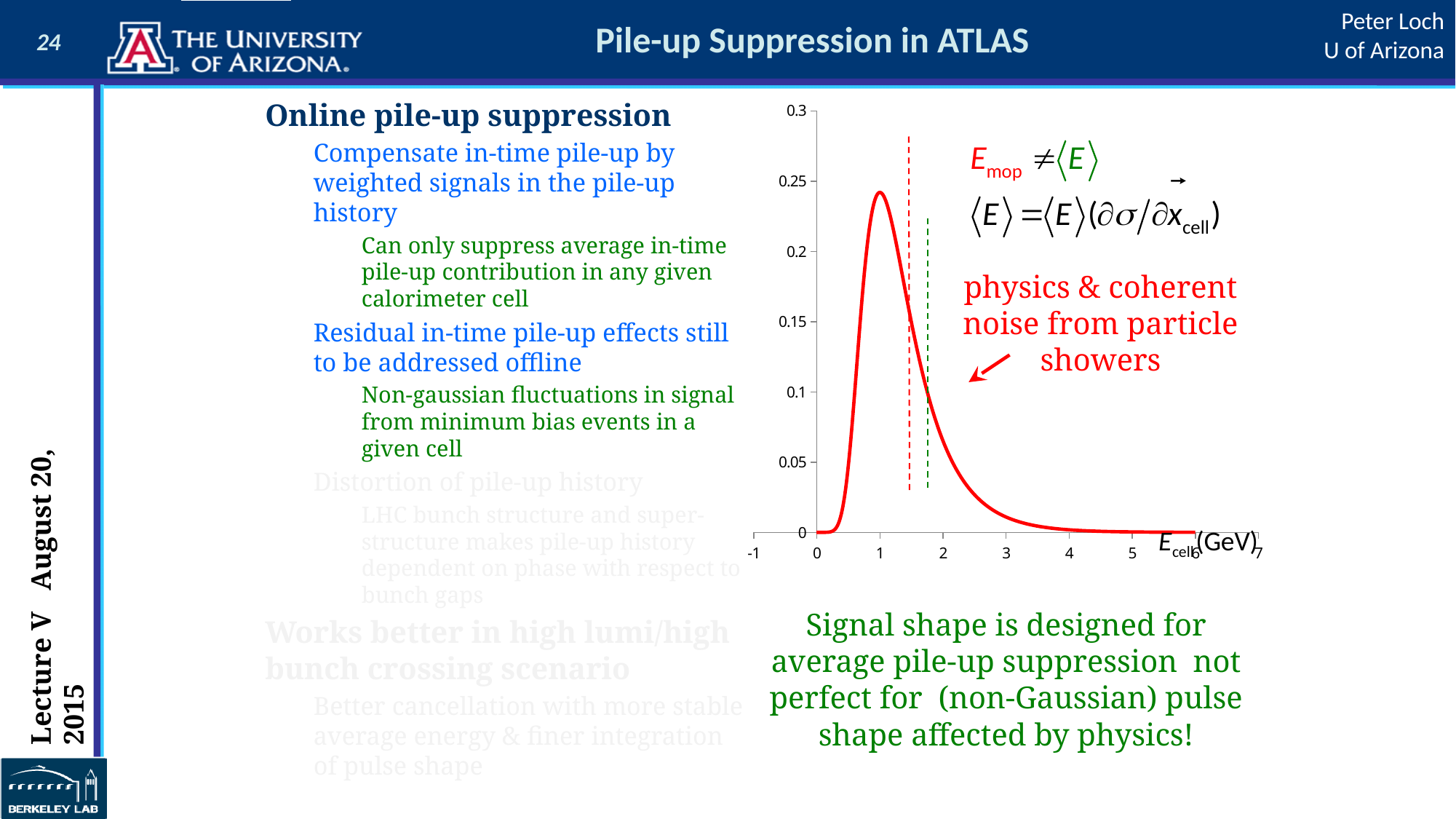
Does the red curve rise or fall as E_cell increases from 0 GeV to 1 GeV? rise What is the lowest tick value shown on the x axis of the chart? -1 Does the red curve rise or fall as E_cell increases from 2 GeV to 5 GeV? fall What kind of chart is shown on the slide? line chart What is the highest tick value shown on the x axis of the chart? 7 What is the label of the x axis of the chart? E_cell (GeV) Is the peak value of the red curve greater or less than 0.2? greater Is the value of the red curve at E_cell = 3 GeV greater or less than 0.05? less Is the peak of the red curve located at an E_cell value greater or less than 2 GeV? less How many dashed vertical lines are drawn on the chart? 2 What is the highest tick value shown on the y axis of the chart? 0.3